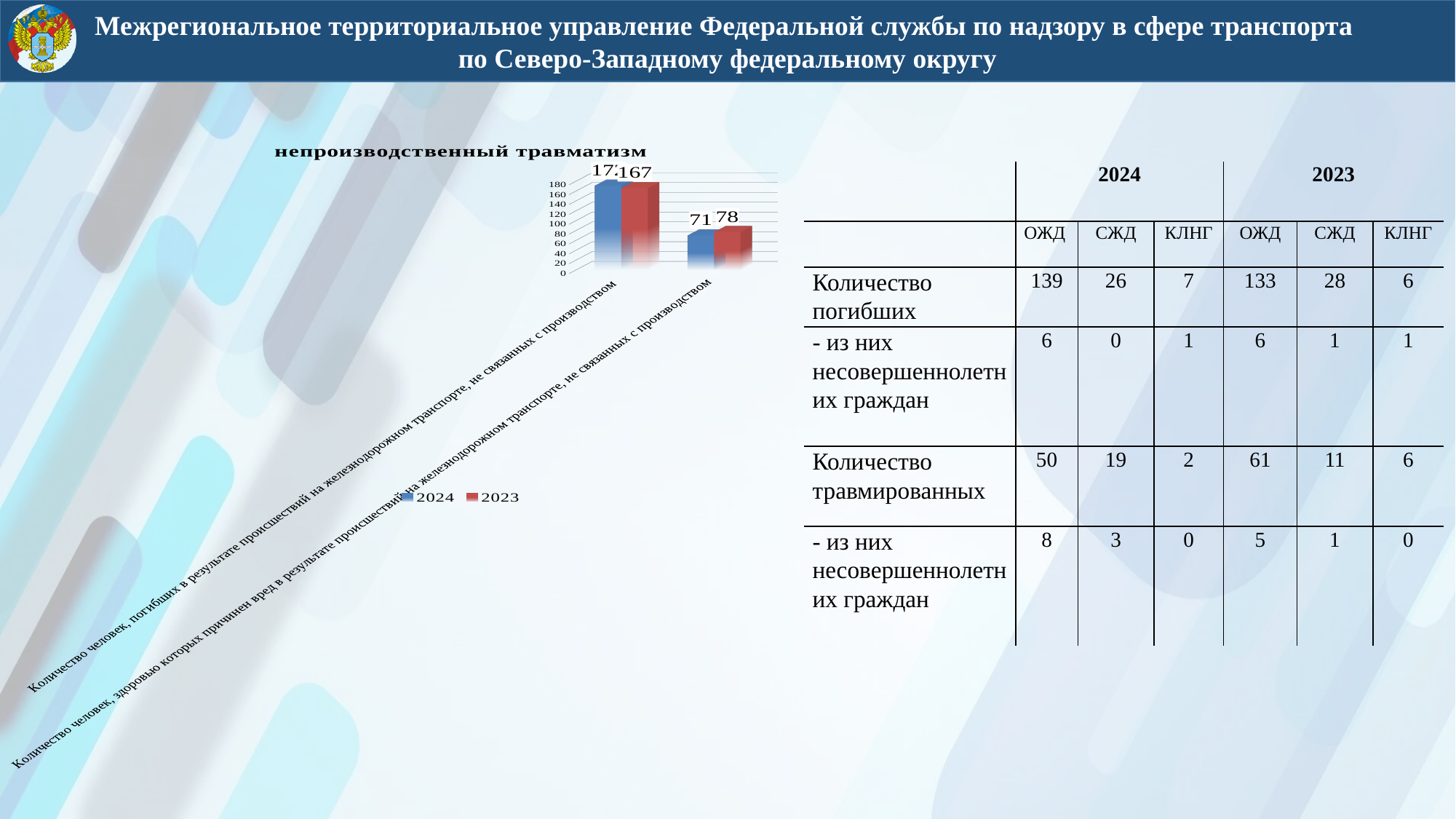
What kind of chart is shown on the slide? bar chart Is the 2024 value for the number of people whose health was harmed greater or less than 100? less How many series does the chart legend list? 2 What is the difference between the 2023 and 2024 values for the number of people whose health was harmed? 7 Which colour represents the 2023 series in the chart? red What is the value for 2024 for the number of people whose health was harmed in railway incidents not related to production? 71 What is the value for 2023 for the number of people killed in railway incidents not related to production? 167 How many categories are shown on the x axis of the chart? 2 For the number of people whose health was harmed, which year has the larger value, 2024 or 2023? 2023 Is the 2024 value for the number of people killed greater or less than 160? greater What is the title of the chart? непроизводственный травматизм What is the value for 2023 for the number of people whose health was harmed in railway incidents not related to production? 78